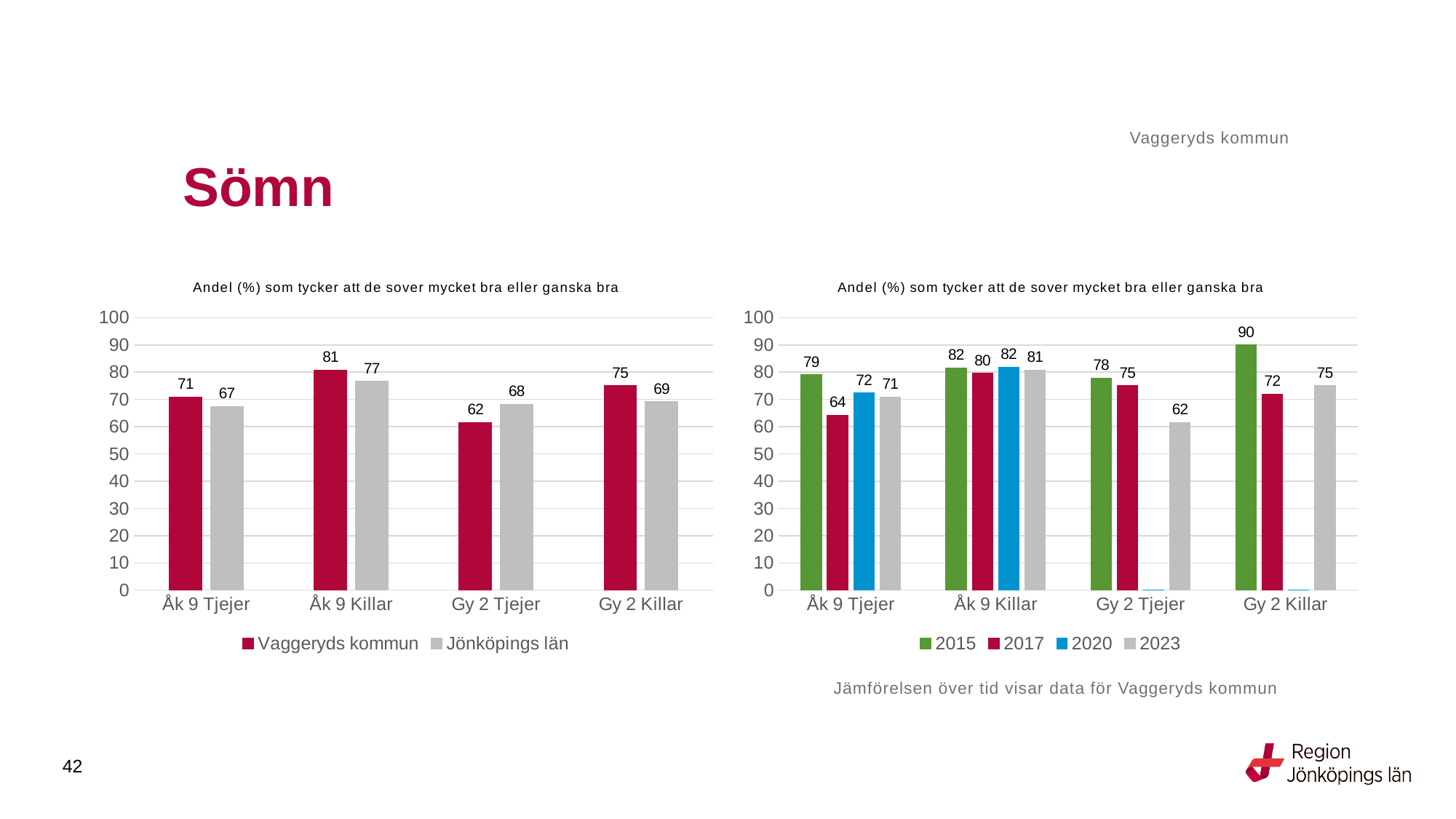
In the right chart, what is the difference between the 2015 and 2023 values for Gy 2 Tjejer? 16 In the right chart, which category has the highest value for 2015? Gy 2 Killar In the left chart, which is larger for Gy 2 Tjejer: Vaggeryds kommun or Jönköpings län? Jönköpings län In the right chart, what is the value for 2015 for Gy 2 Killar? 90 In the left chart, what is the value for Vaggeryds kommun for Åk 9 Killar? 81 How many series does the legend of the left chart list? 2 How many series does the legend of the right chart list? 4 In the right chart, what is the value for 2017 for Åk 9 Tjejer? 64 In the left chart, what is the difference between Vaggeryds kommun and Jönköpings län for Gy 2 Killar? 6 In the left chart, which category has the lowest value for Vaggeryds kommun? Gy 2 Tjejer In the left chart, what is the value for Jönköpings län for Gy 2 Tjejer? 68 What type of chart is the right chart? Bar chart